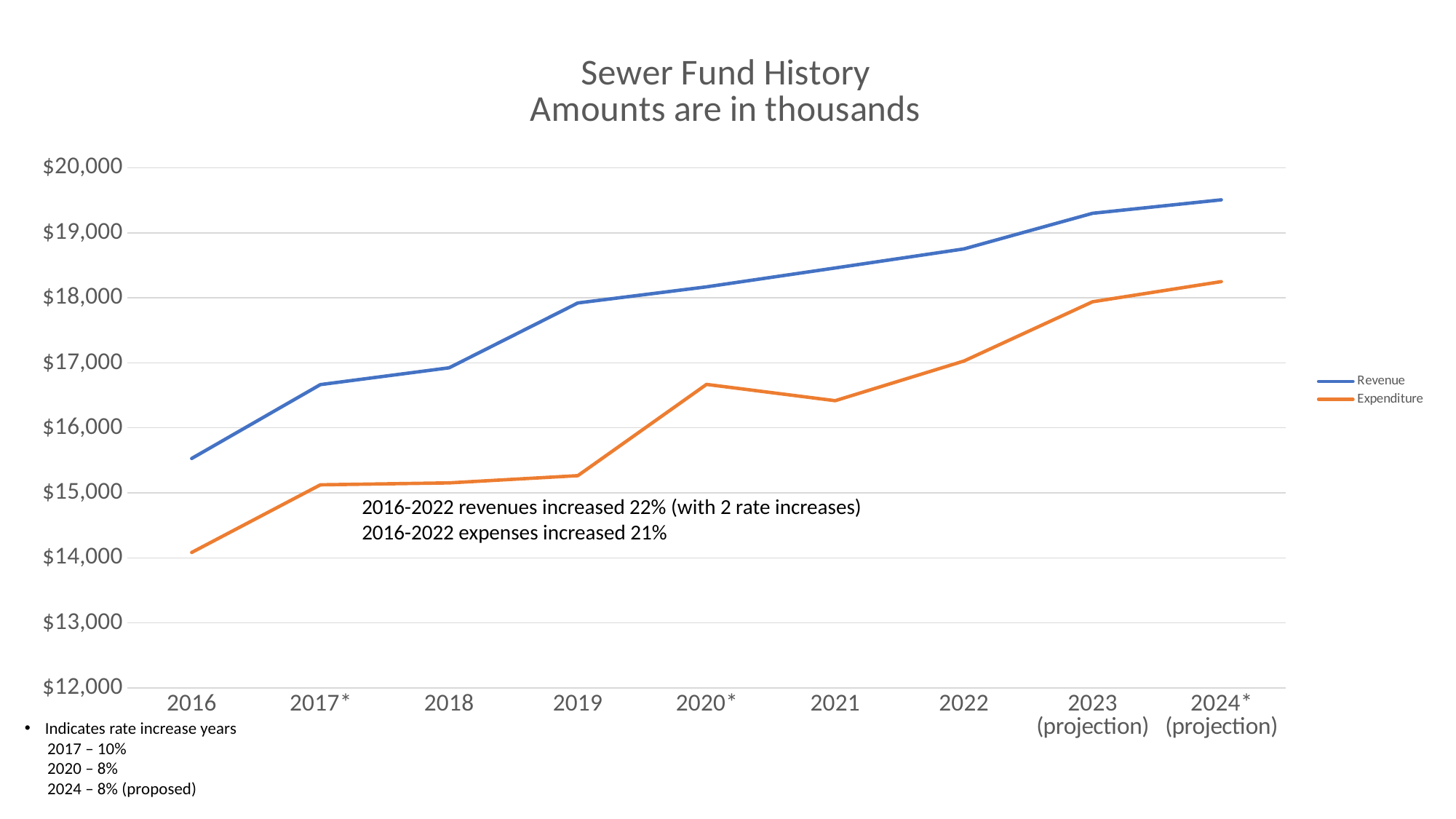
Does Revenue rise or fall from 2016 to 2024* (projection)? rise Which is larger in 2020*, Revenue or Expenditure? Revenue Is the Expenditure value for 2020* greater or less than $17,000? less How many series does the legend list? 2 What kind of chart is shown on the slide? line chart In which year is Expenditure lowest? 2016 In which year is Revenue highest? 2024* (projection) Does Expenditure rise or fall from 2020* to 2021? fall Is the Revenue value for 2023 (projection) greater or less than $19,000? greater Is the Revenue value for 2016 greater or less than $15,000? greater How many years are plotted along the x axis? 9 Which series is drawn in orange? Expenditure